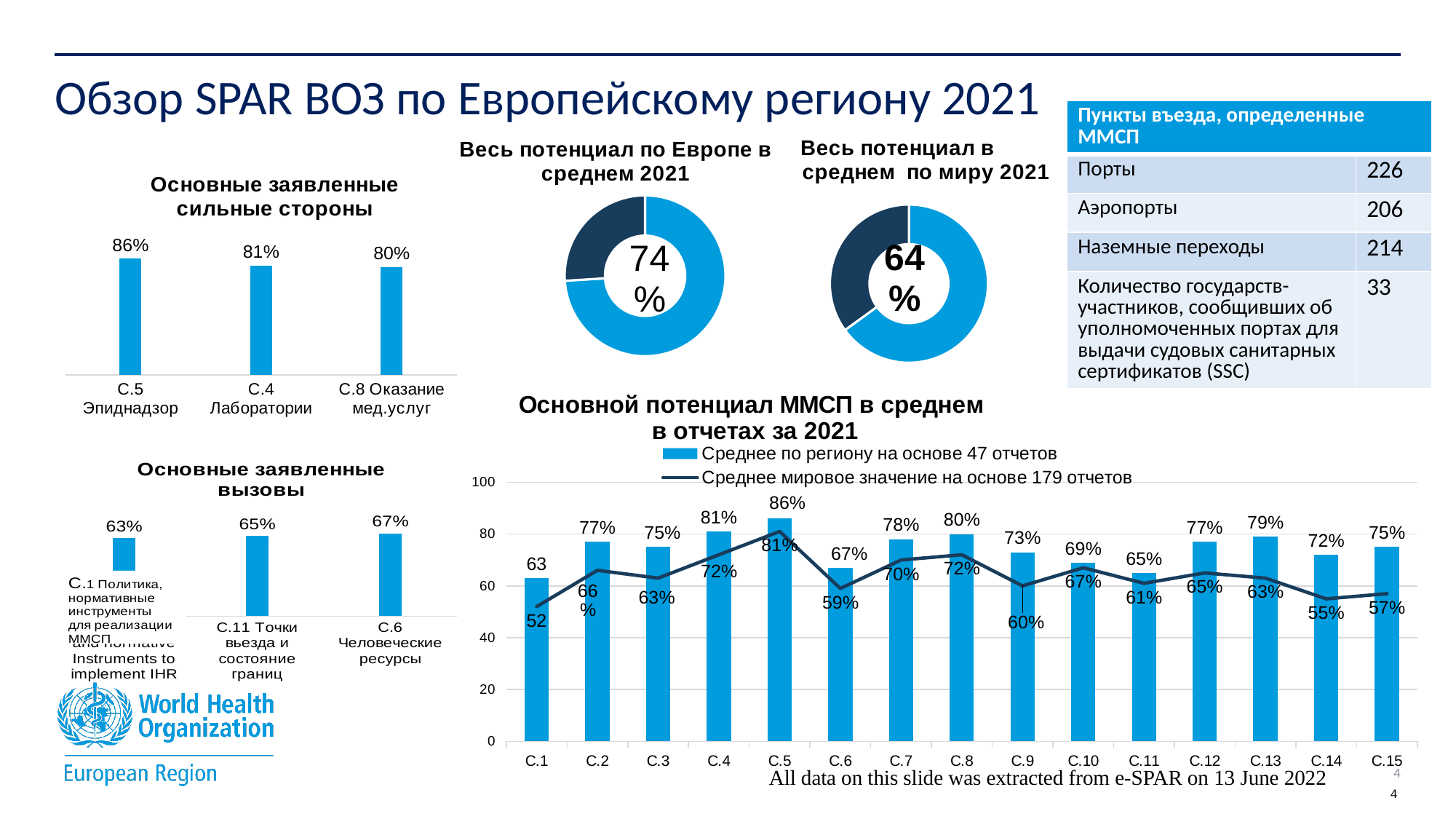
In the chart 'Основные заявленные вызовы', what is the difference between 'C.6 Человеческие ресурсы' and 'C.1 Политика, нормативные инструменты для реализации ММСП'? 4% In the chart 'Основной потенциал ММСП в среднем в отчетах за 2021', what is the value of 'Среднее мировое значение на основе 179 отчетов' for C.14? 55% In the chart 'Основной потенциал ММСП в среднем в отчетах за 2021', what is the value of 'Среднее по региону на основе 47 отчетов' for C.5? 86% In the chart 'Основной потенциал ММСП в среднем в отчетах за 2021', what is the difference between the regional average and the world average for C.9? 13% In the chart 'Основные заявленные вызовы', which category has the highest value? C.6 Человеческие ресурсы In the chart 'Основной потенциал ММСП в среднем в отчетах за 2021', how many series does the legend list? 2 In the chart 'Основной потенциал ММСП в среднем в отчетах за 2021', which category has the highest regional average bar? C.5 In the chart 'Основной потенциал ММСП в среднем в отчетах за 2021', which category has the lowest regional average bar? C.1 What value is shown in the centre of the donut chart 'Весь потенциал в среднем по миру 2021'? 64% In the chart 'Основной потенциал ММСП в среднем в отчетах за 2021', how many categories are shown on the x axis? 15 What kind of chart is 'Весь потенциал по Европе в среднем 2021'? Donut (pie) chart In the chart 'Основные заявленные сильные стороны', what is the value for 'C.4 Лаборатории'? 81%